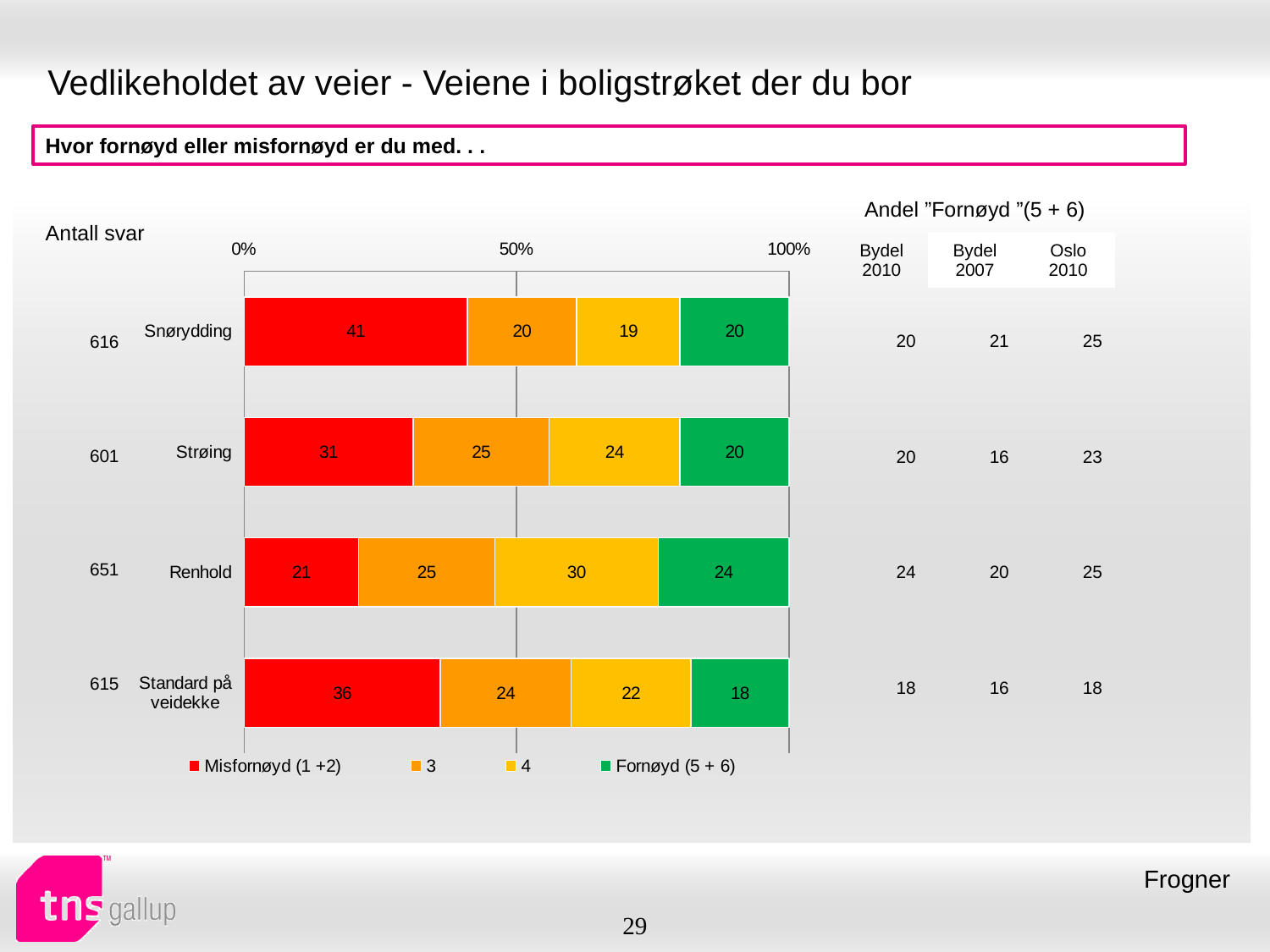
How many categories are shown in the bar chart? 4 Which category has the highest 'Misfornøyd (1 +2)' value? Snørydding What is the difference between the 'Misfornøyd (1 +2)' values for Snørydding and Renhold? 20 What is the total of the stacked bar for Strøing? 100 What kind of chart is shown on the slide? Stacked bar chart Which colour represents the 'Fornøyd (5 + 6)' series in the legend? Green What is the value of the '4' segment for Strøing? 24 How many series does the legend list? 4 Which category has the lowest 'Fornøyd (5 + 6)' value? Standard på veidekke What is the value of the 'Fornøyd (5 + 6)' segment for Renhold? 24 What is the value of the 'Misfornøyd (1 +2)' segment for Snørydding? 41 Which is larger: the '3' segment for Standard på veidekke or the '3' segment for Snørydding? Standard på veidekke